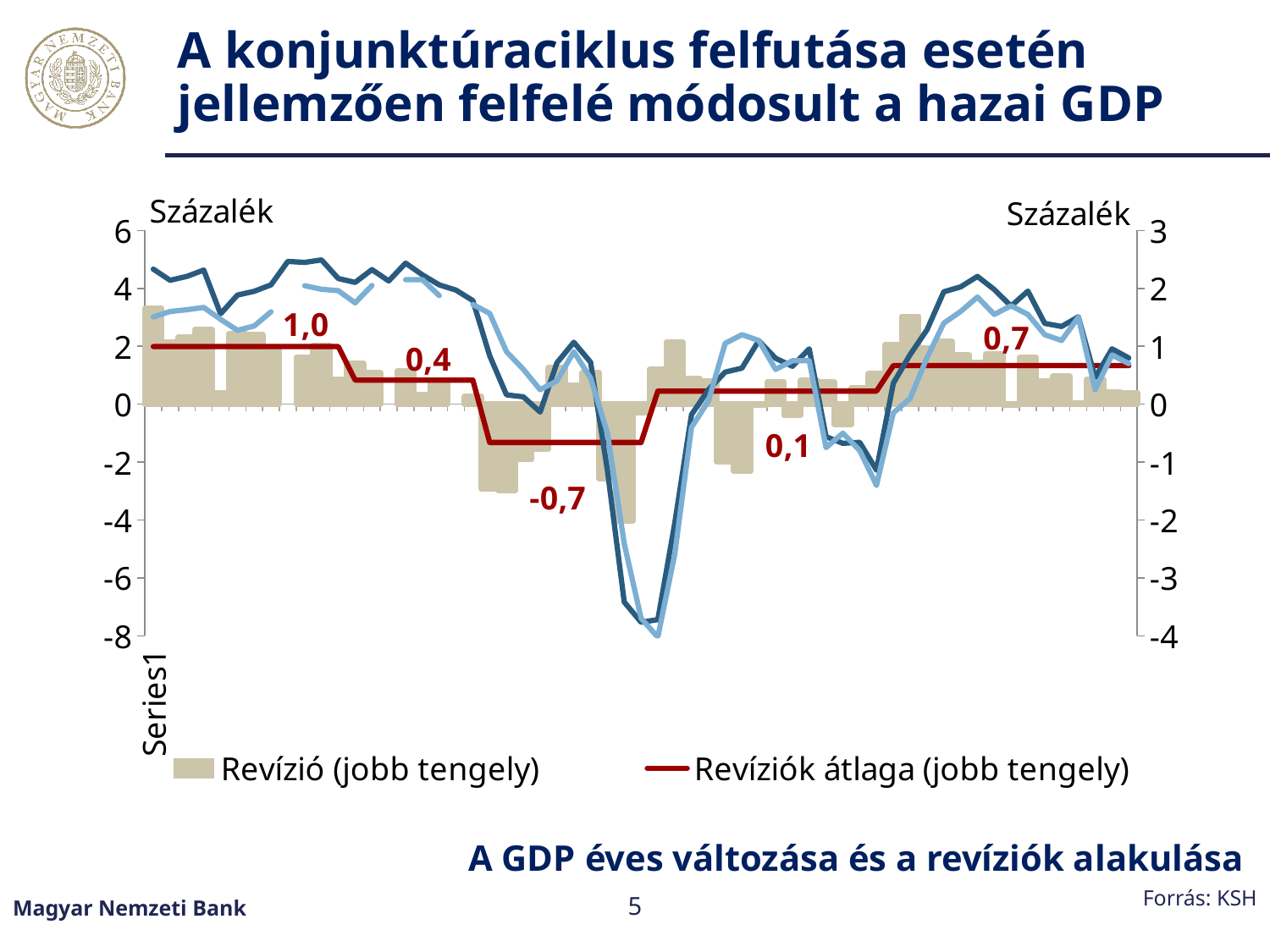
What is the difference between the labelled values 0,7 and 0,1 on the red average line? 0,6 What is the highest value labelled on the red 'Revíziók átlaga (jobb tengely)' line? 1,0 What kind of chart is shown on the slide? Combined bar and line chart What is the title of the chart? A GDP éves változása és a revíziók alakulása What is the difference between the highest labelled value (1,0) and the lowest labelled value (-0,7) on the red average line? 1,7 Does the red average line rise or fall when it moves from the segment labelled 1,0 to the segment labelled 0,4? fall What is the maximum value shown on the right-hand axis? 3 How many entries does the legend list? 2 Is the lowest point of the dark blue line greater or less than -6 on the left axis? less How many data labels are printed on the red 'Revíziók átlaga (jobb tengely)' line? 5 Which labelled value on the red average line is larger, 0,4 or 0,7? 0,7 What is the lowest value labelled on the red 'Revíziók átlaga (jobb tengely)' line? -0,7